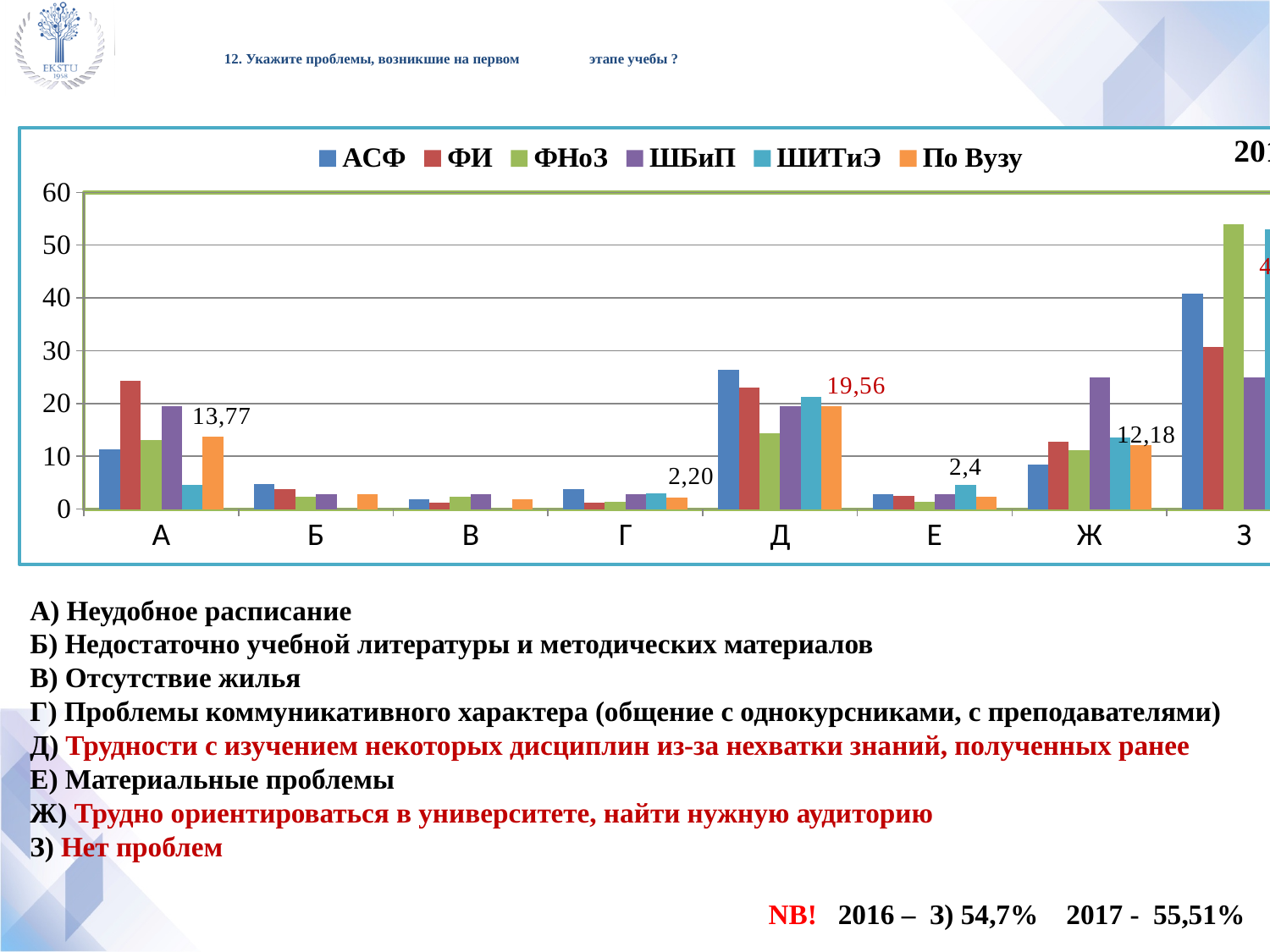
How many series does the legend list? 6 What is the value of the По Вузу series for category Ж? 12,18 What is the value of the По Вузу series for category Г? 2,20 Is the value of the АСФ series for category Д greater or less than 20? greater What is the value of the По Вузу series for category А? 13,77 What is the value of the По Вузу series for category Д? 19,56 Which colour represents the По Вузу series in the legend? orange What kind of chart is shown on the slide? bar chart What is the difference between the По Вузу values for categories Д and А? 5,79 Which is larger for category А: the АСФ bar or the ФИ bar? ФИ How many categories are shown on the x axis? 8 What is the value of the По Вузу series for category Е? 2,4